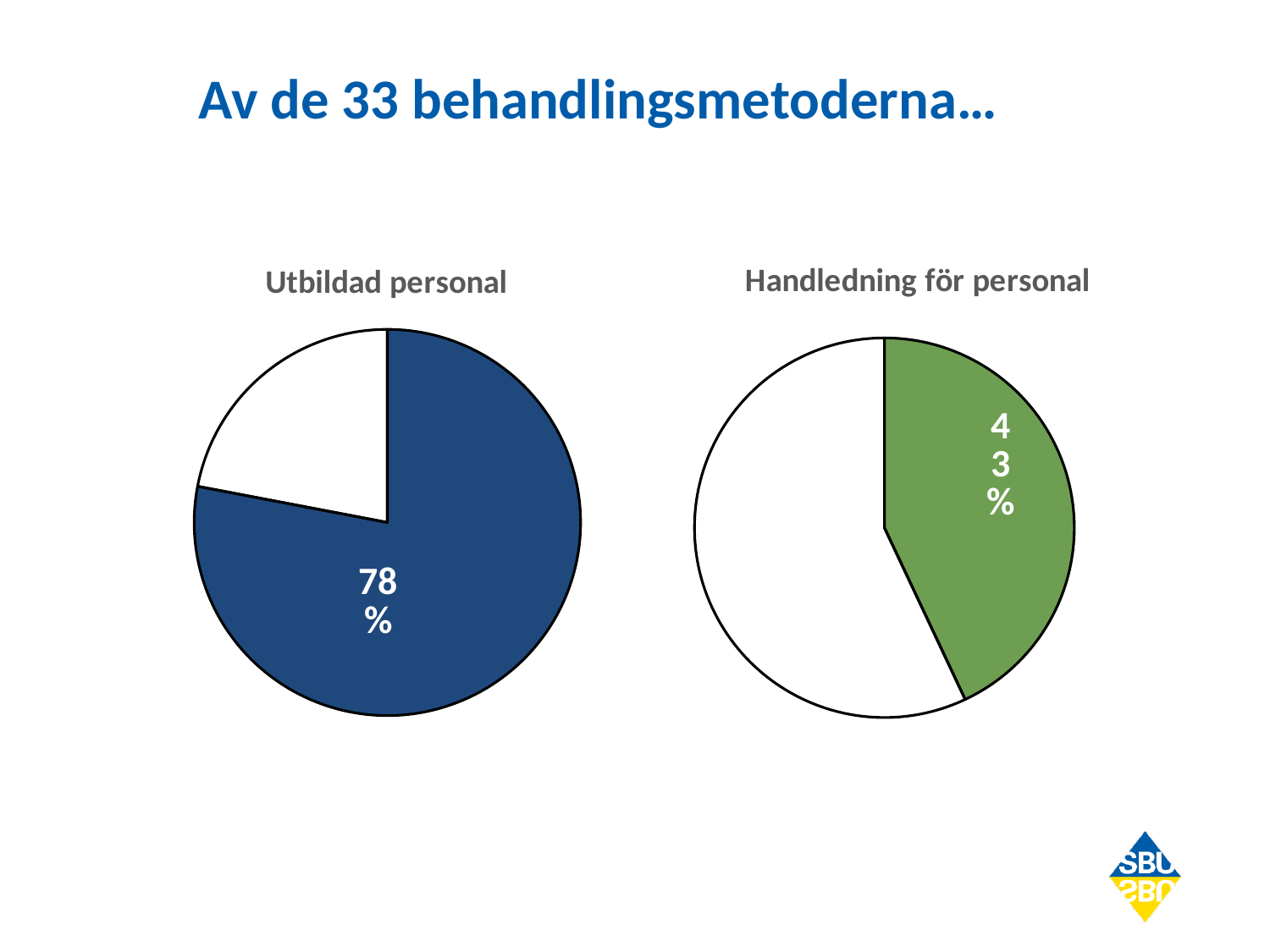
How many slices does the 'Handledning för personal' pie chart have? 2 What is the difference in percentage points between the labelled slice in 'Utbildad personal' (78%) and the labelled slice in 'Handledning för personal' (43%)? 35 percentage points In the 'Handledning för personal' chart, what percentage is shown on the green slice? 43% How many slices does the 'Utbildad personal' pie chart have? 2 What is the title of the slide above the two pie charts? Av de 33 behandlingsmetoderna… What type of chart is 'Utbildad personal'? Pie chart What type of chart is 'Handledning för personal'? Pie chart In the 'Utbildad personal' chart, what percentage is shown on the blue slice? 78% In the 'Handledning för personal' chart, is the green slice greater or less than 50%? less What colour is the labelled slice in the 'Handledning för personal' chart? Green In the 'Utbildad personal' chart, is the blue slice greater or less than 50%? greater Which is larger: the labelled share in the 'Utbildad personal' chart or the labelled share in the 'Handledning för personal' chart? Utbildad personal